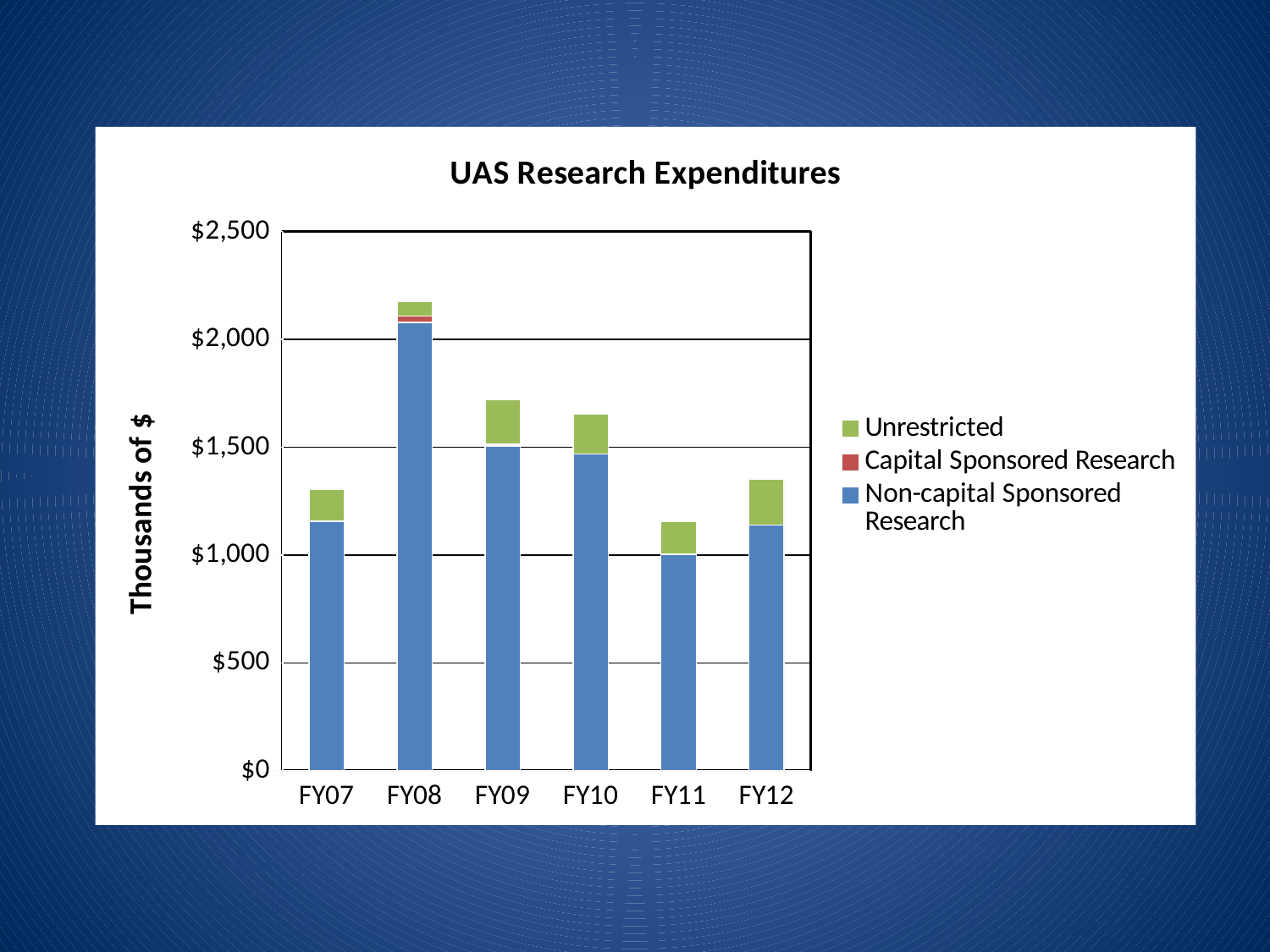
How many fiscal years are shown on the x axis of the chart? 6 What kind of chart is shown on the slide? Stacked bar chart Which fiscal year has the highest total research expenditures? FY08 How many series does the legend list? 3 What is the label on the vertical axis of the chart? Thousands of $ Which fiscal year has the lowest total research expenditures? FY11 Is the total research expenditure for FY11 greater or less than $1,500? less Is the total research expenditure for FY08 greater or less than $2,000? greater Is the Non-capital Sponsored Research value for FY08 greater or less than $2,000? greater What is the title of the chart? UAS Research Expenditures Which fiscal year has the larger total research expenditure, FY09 or FY10? FY09